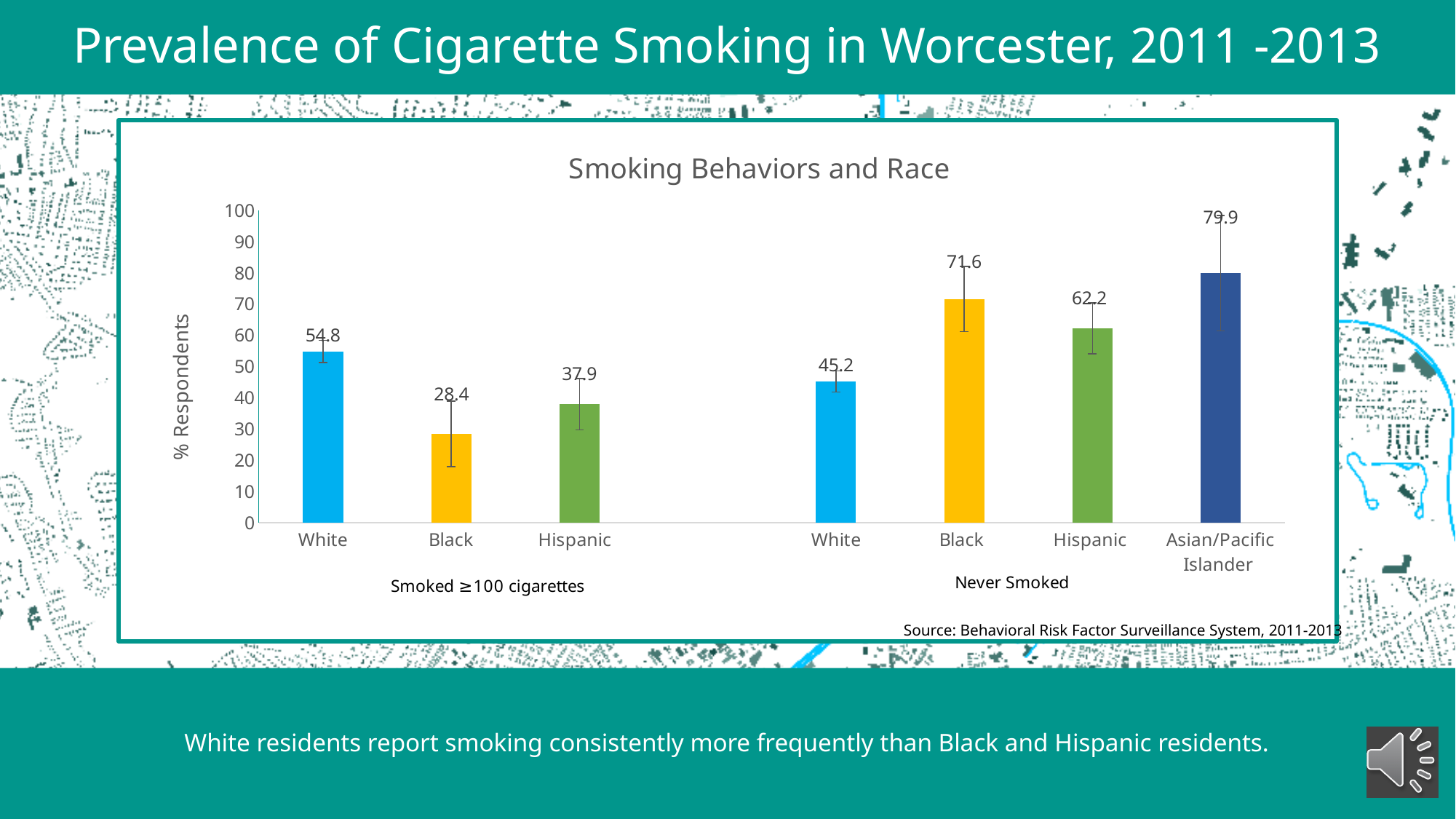
Is the value for White in the 'Never Smoked' group greater or less than 50? less What kind of chart is shown on the slide? bar chart What is the label of the vertical axis? % Respondents What is the difference between the White and Black values in the 'Smoked ≥100 cigarettes' group? 26.4 Which category has the lowest value in the 'Smoked ≥100 cigarettes' group? Black How many bars are plotted in the chart in total? 7 What is the value for Asian/Pacific Islander in the 'Never Smoked' group? 79.9 Which category has the highest value in the 'Never Smoked' group? Asian/Pacific Islander Which is larger: the Hispanic value in the 'Never Smoked' group or the Hispanic value in the 'Smoked ≥100 cigarettes' group? Never Smoked What is the value for Black in the 'Never Smoked' group? 71.6 What is the title of the chart? Smoking Behaviors and Race What is the value for White in the 'Smoked ≥100 cigarettes' group? 54.8